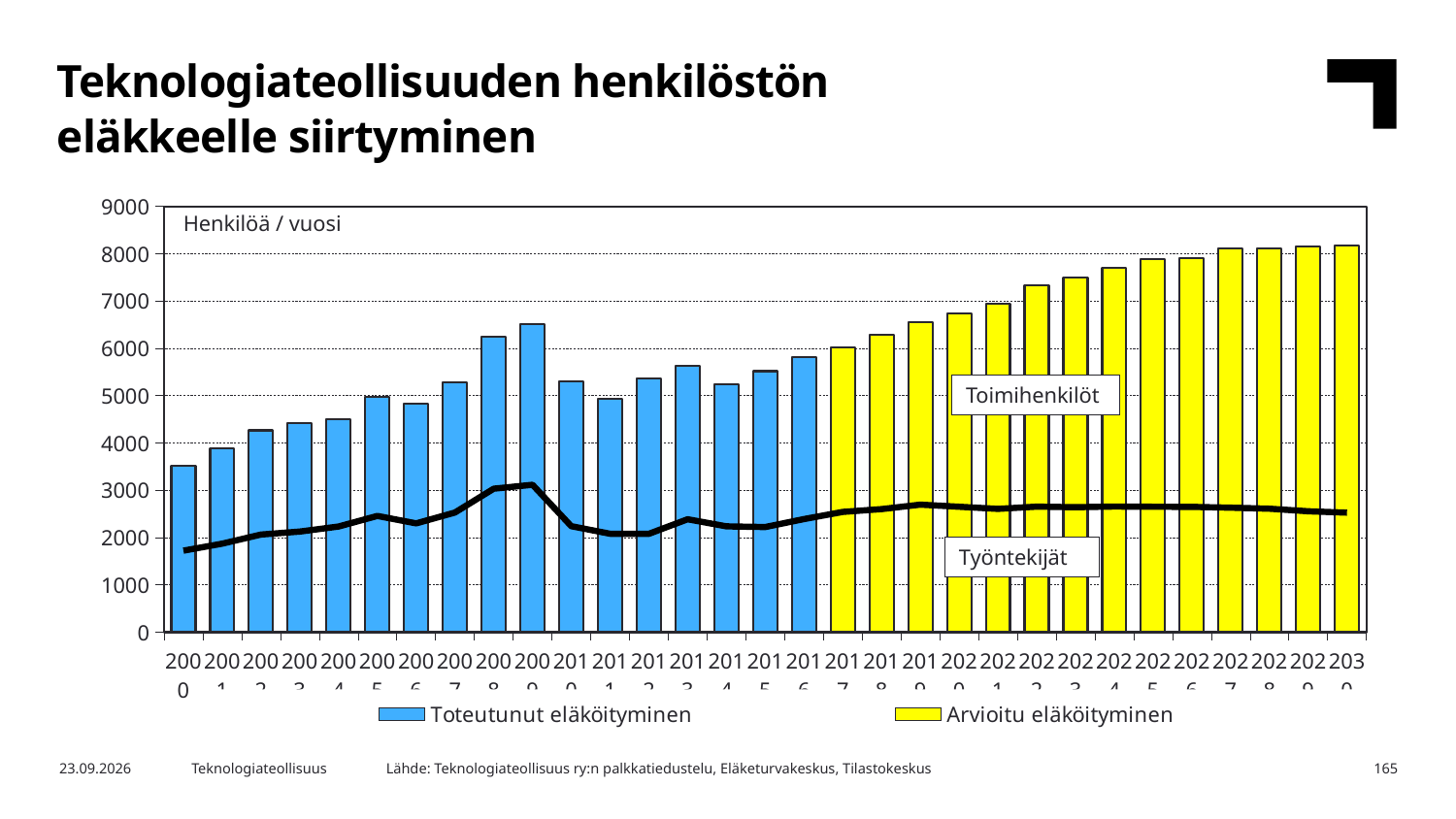
Do the yellow 'Arvioitu eläköityminen' bars rise or fall from 2017 to 2030? rise Among the blue 'Toteutunut eläköityminen' bars, which year is highest? 2009 Is the bar for 2009 greater or less than 6000? greater Which year has the lowest bar? 2000 Is the bar for 2016 greater or less than 6000? less What unit label is shown at the top left inside the plot area? Henkilöä / vuosi How many series does the legend list? 2 Which bar is larger, 2009 or 2010? 2009 Is the bar for 2023 greater or less than 7000? greater What kind of chart is shown on the slide? bar and line chart How many years (bars) are plotted along the x axis? 31